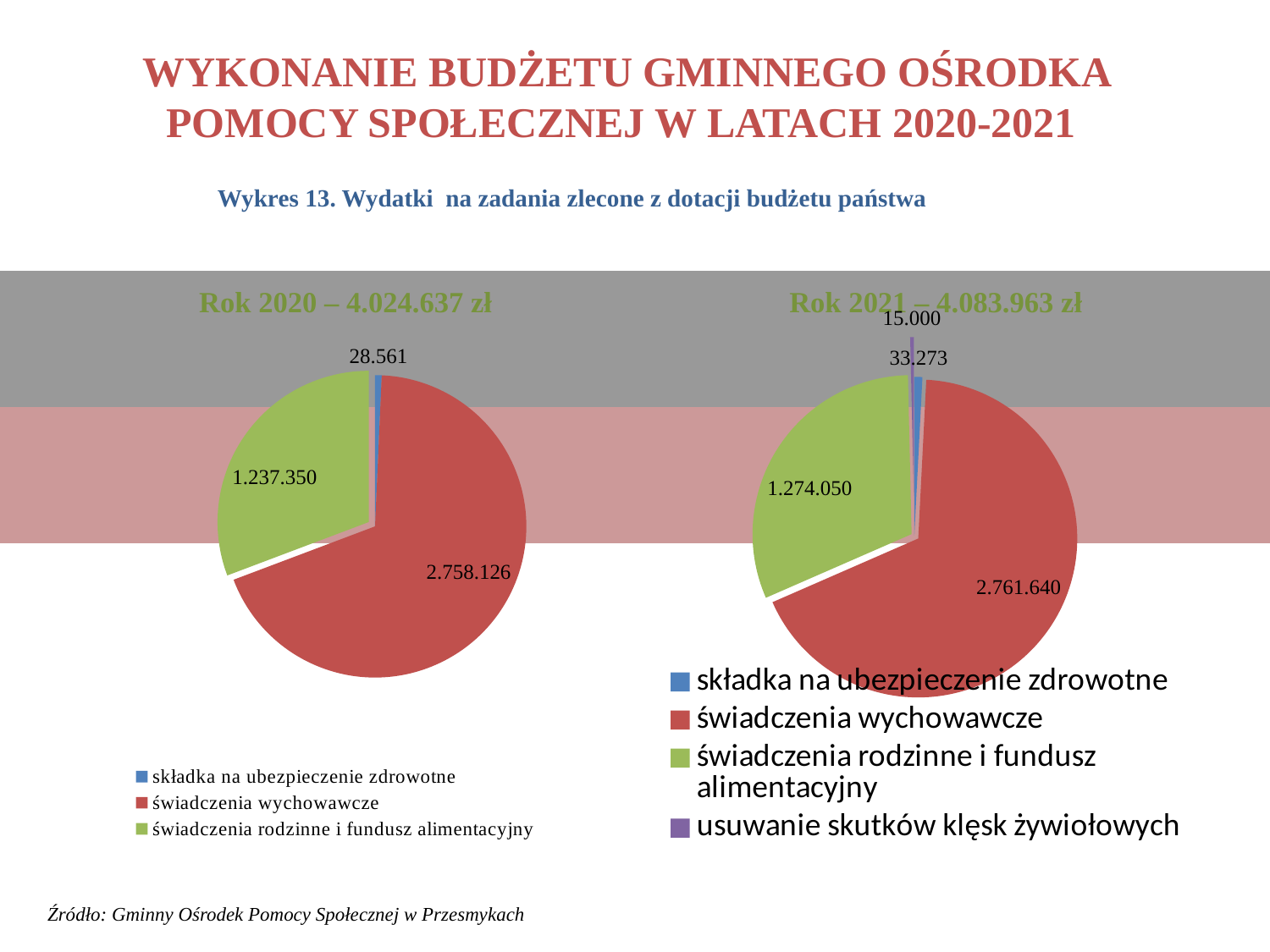
What kind of charts are shown on the slide? Pie charts In the Rok 2021 chart, which is larger: składka na ubezpieczenie zdrowotne or usuwanie skutków klęsk żywiołowych? składka na ubezpieczenie zdrowotne What is the difference between składka na ubezpieczenie zdrowotne in the Rok 2021 chart and in the Rok 2020 chart? 4.712 In the Rok 2020 chart, what is the value for składka na ubezpieczenie zdrowotne? 28.561 In the Rok 2021 chart, what is the value for usuwanie skutków klęsk żywiołowych? 15.000 In the Rok 2020 chart, which category has the smallest slice? składka na ubezpieczenie zdrowotne What is the difference between świadczenia wychowawcze in the Rok 2021 chart and in the Rok 2020 chart? 3.514 How many slices does the Rok 2020 pie chart have? 3 How many categories does the legend of the Rok 2021 chart list? 4 In the Rok 2021 chart, what is the value for świadczenia rodzinne i fundusz alimentacyjny? 1.274.050 In the Rok 2020 chart, what is the value for świadczenia wychowawcze? 2.758.126 In the Rok 2021 chart, which category has the largest slice? świadczenia wychowawcze